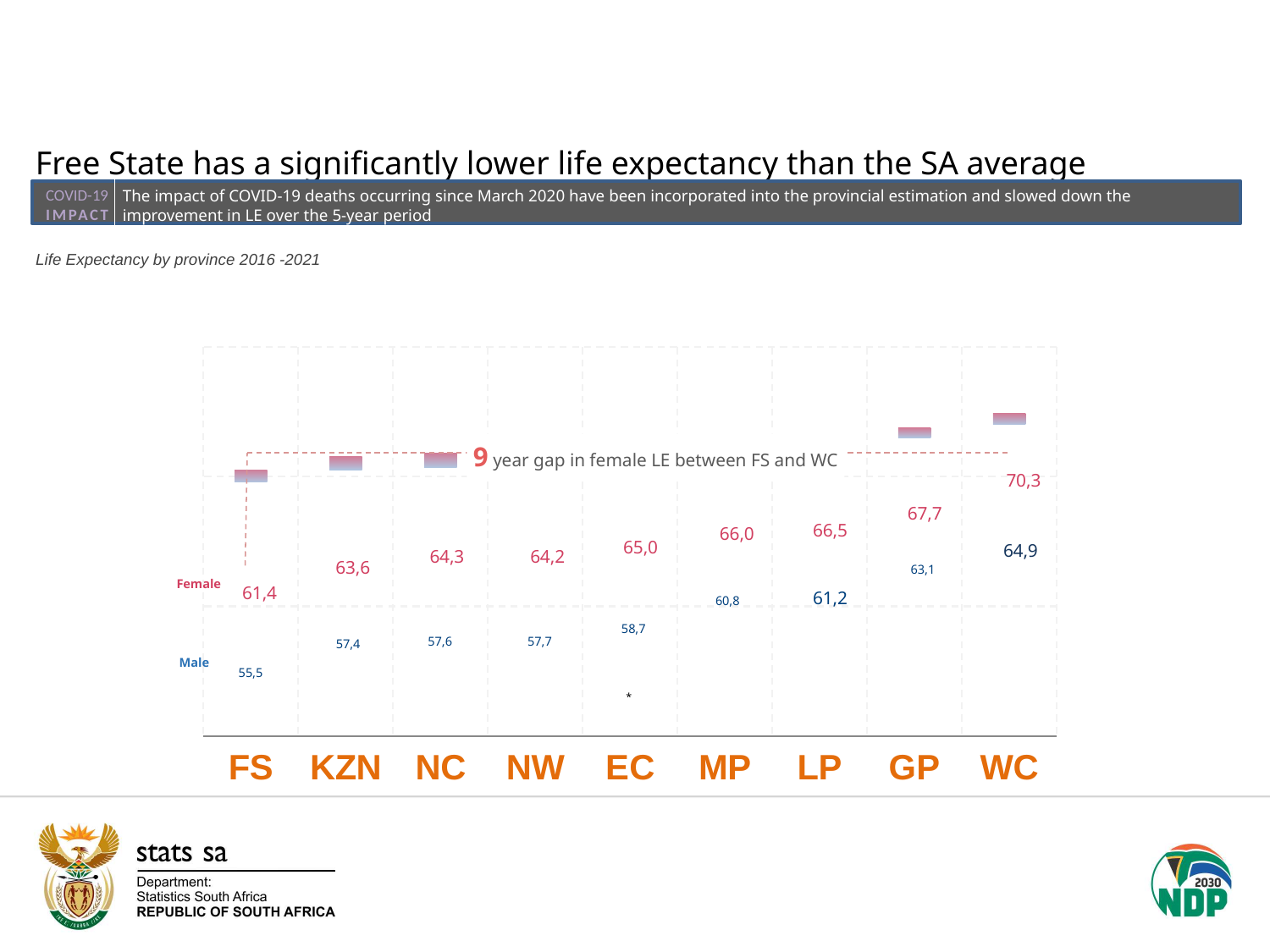
Do the female life expectancy values generally rise or fall from FS to WC along the x axis? rise What is the female life expectancy for Free State (FS)? 61,4 Which province has the lowest male life expectancy? FS What is the male life expectancy for Western Cape (WC)? 64,9 According to the annotation on the chart, how many years is the gap in female life expectancy between FS and WC? 9 What is the difference between female and male life expectancy in Limpopo (LP)? 5,3 What is the difference between the female life expectancy of WC and FS? 8,9 Which is higher, the male life expectancy in MP or in KZN? MP What is the male life expectancy for Eastern Cape (EC)? 58,7 How many provinces are shown on the x axis of the chart? 9 Which province has the highest female life expectancy? WC What is the female life expectancy for Gauteng (GP)? 67,7